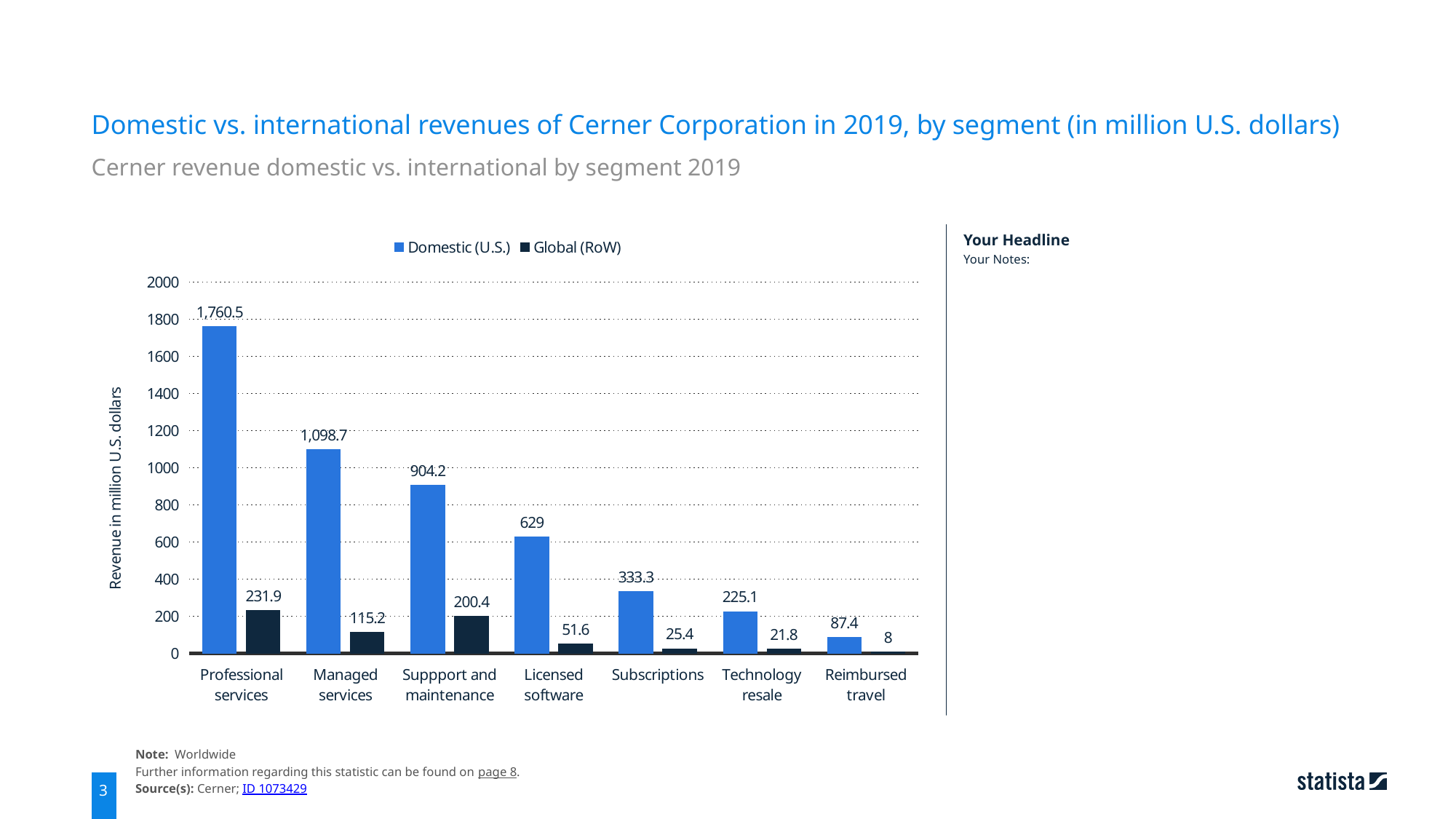
What is the Global (RoW) revenue for Reimbursed travel? 8 What is the label of the y axis? Revenue in million U.S. dollars What kind of chart is shown on the slide? Bar chart How many segments are shown on the x axis? 7 Which segment has the highest Domestic (U.S.) revenue? Professional services What is the Domestic (U.S.) revenue for Subscriptions? 333.3 What is the Domestic (U.S.) revenue for Professional services? 1,760.5 How many series does the legend list? 2 What is the difference between the Domestic (U.S.) and Global (RoW) revenue for Licensed software? 577.4 Which segment has the lowest Global (RoW) revenue? Reimbursed travel Which is larger: the Global (RoW) revenue for Professional services or the Domestic (U.S.) revenue for Technology resale? Global (RoW) revenue for Professional services What is the Global (RoW) revenue for Managed services? 115.2